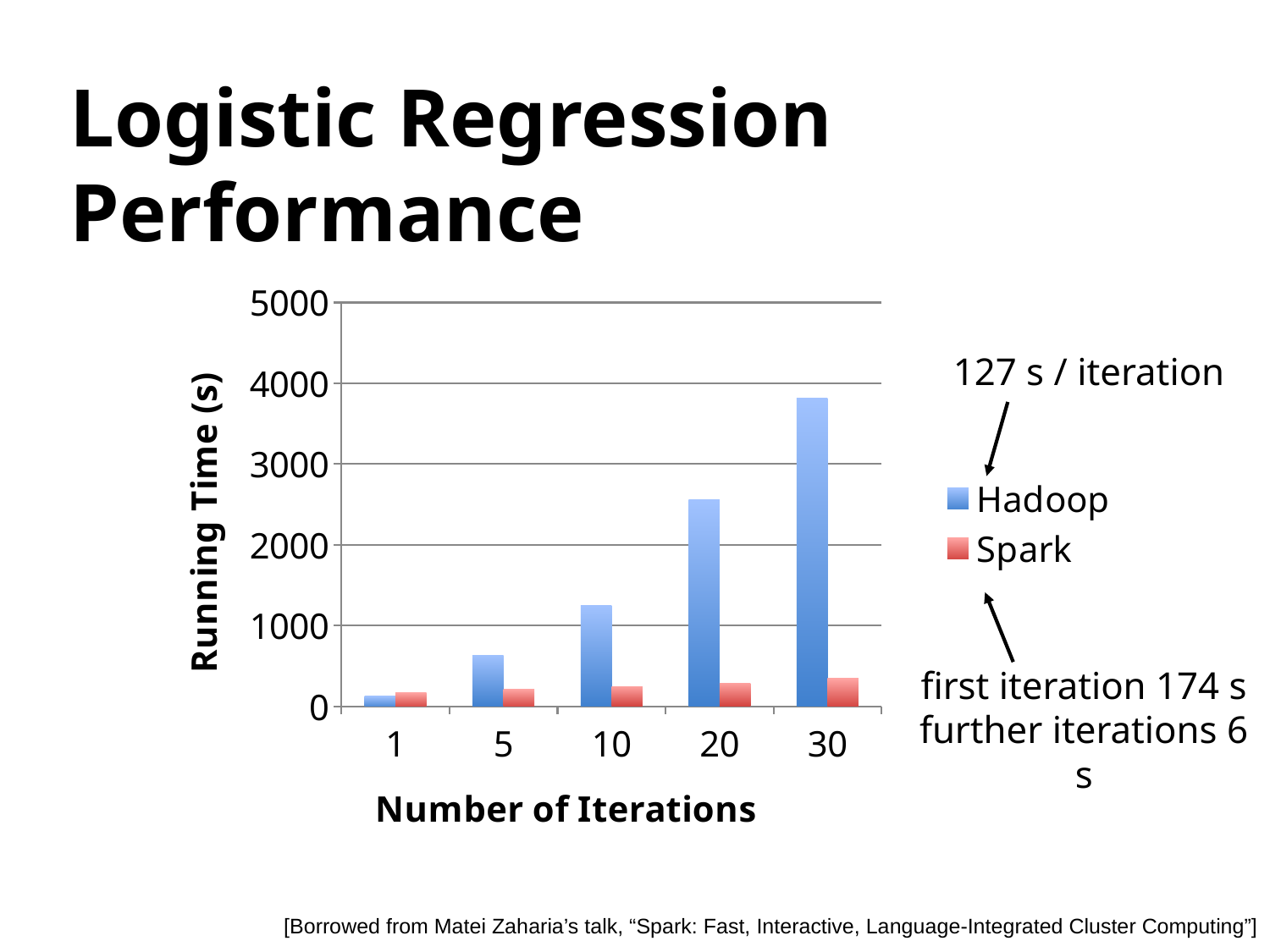
Is the Spark running time at 30 iterations greater or less than 1000? less At which number of iterations is the Hadoop running time highest? 30 Is the Hadoop running time at 5 iterations greater or less than 1000? less At 30 iterations, which has the larger running time, Hadoop or Spark? Hadoop Is the Hadoop running time at 20 iterations greater or less than 2000? greater How many iteration counts are shown on the x axis? 5 What is the label of the y axis? Running Time (s) At which number of iterations is the Hadoop running time lowest? 1 How many series does the legend list? 2 What kind of chart is shown on the slide? bar chart Does the Hadoop running time rise or fall as the number of iterations increases? rise